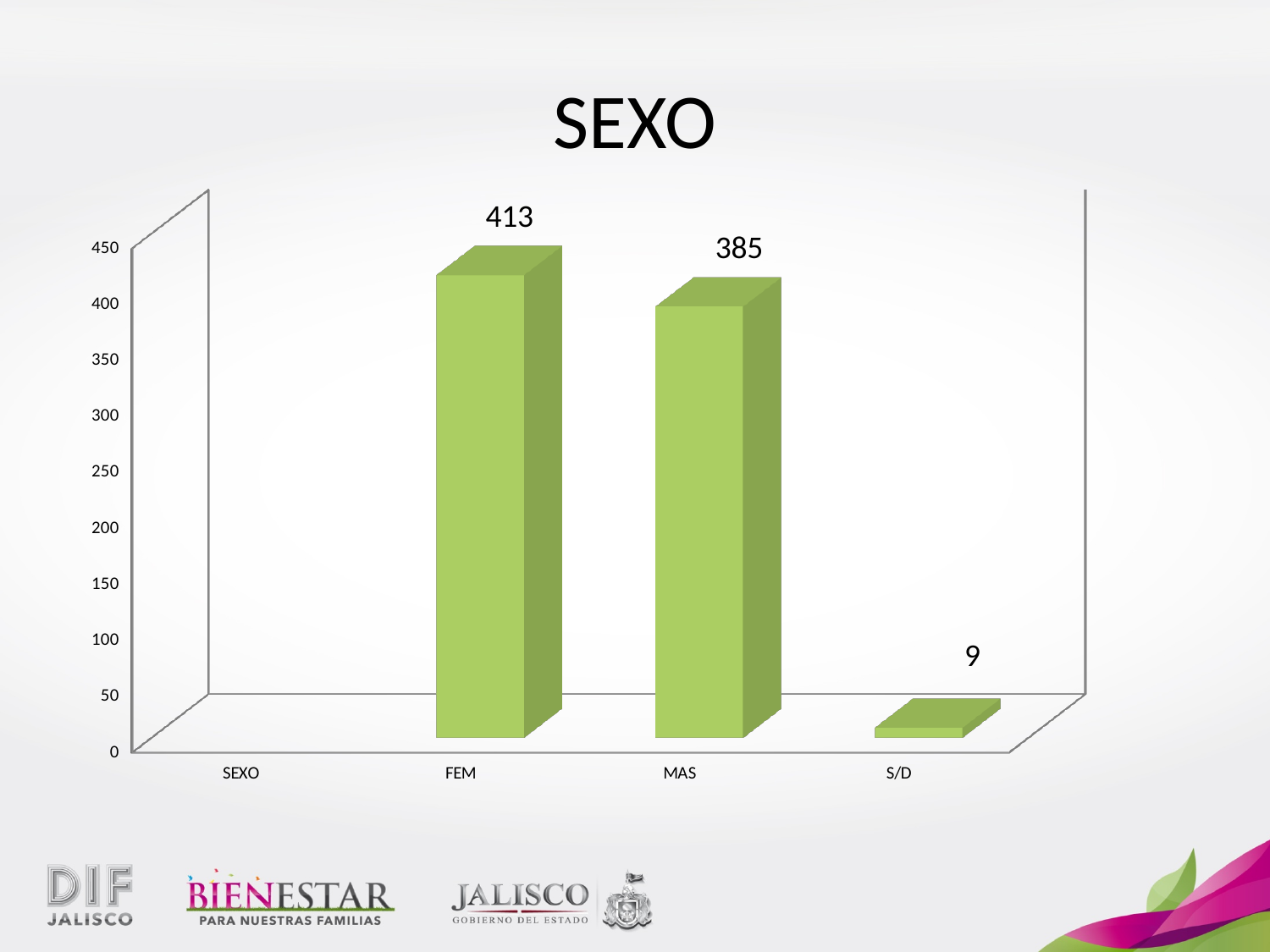
What is the value for MAS? 385 What is the value for FEM? 413 Which category has the highest value? FEM Is the value for MAS greater or less than 400? less How many categories are shown on the x axis? 4 Which is larger, the value for FEM or the value for MAS? FEM Which category has the lowest value? S/D What is the title of the chart? SEXO What is the difference between the values for FEM and MAS? 28 What kind of chart is shown on the slide? bar chart What is the difference between the values for MAS and S/D? 376 What is the value for S/D? 9